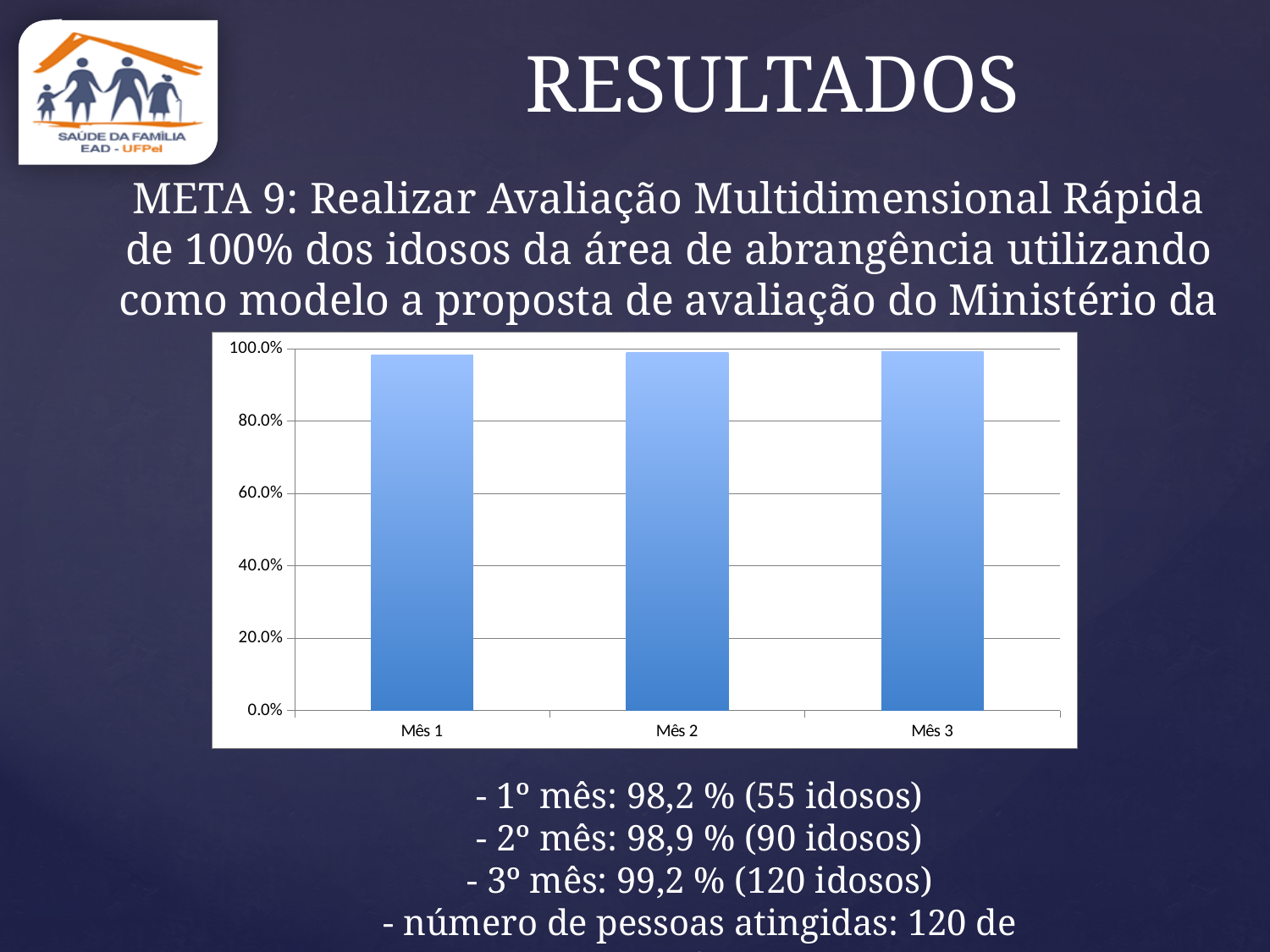
What kind of chart is shown on the slide? bar chart Is the value for Mês 3 greater or less than 80.0%? greater Is the value for Mês 1 greater or less than 80.0%? greater According to the slide text, which month has the highest percentage? Mês 3 Do the values rise or fall from Mês 1 to Mês 3? rise How many bars (categories) does the chart show? 3 According to the slide, what percentage was reached in the 2º mês (Mês 2)? 98,9 % What is the highest tick value shown on the y axis of the chart? 100.0% Is the value for Mês 2 greater or less than 60.0%? greater What are the category labels on the x axis of the chart? Mês 1, Mês 2, Mês 3 According to the slide, what percentage was reached in the 3º mês (Mês 3)? 99,2 % According to the slide, what percentage was reached in the 1º mês (Mês 1)? 98,2 %